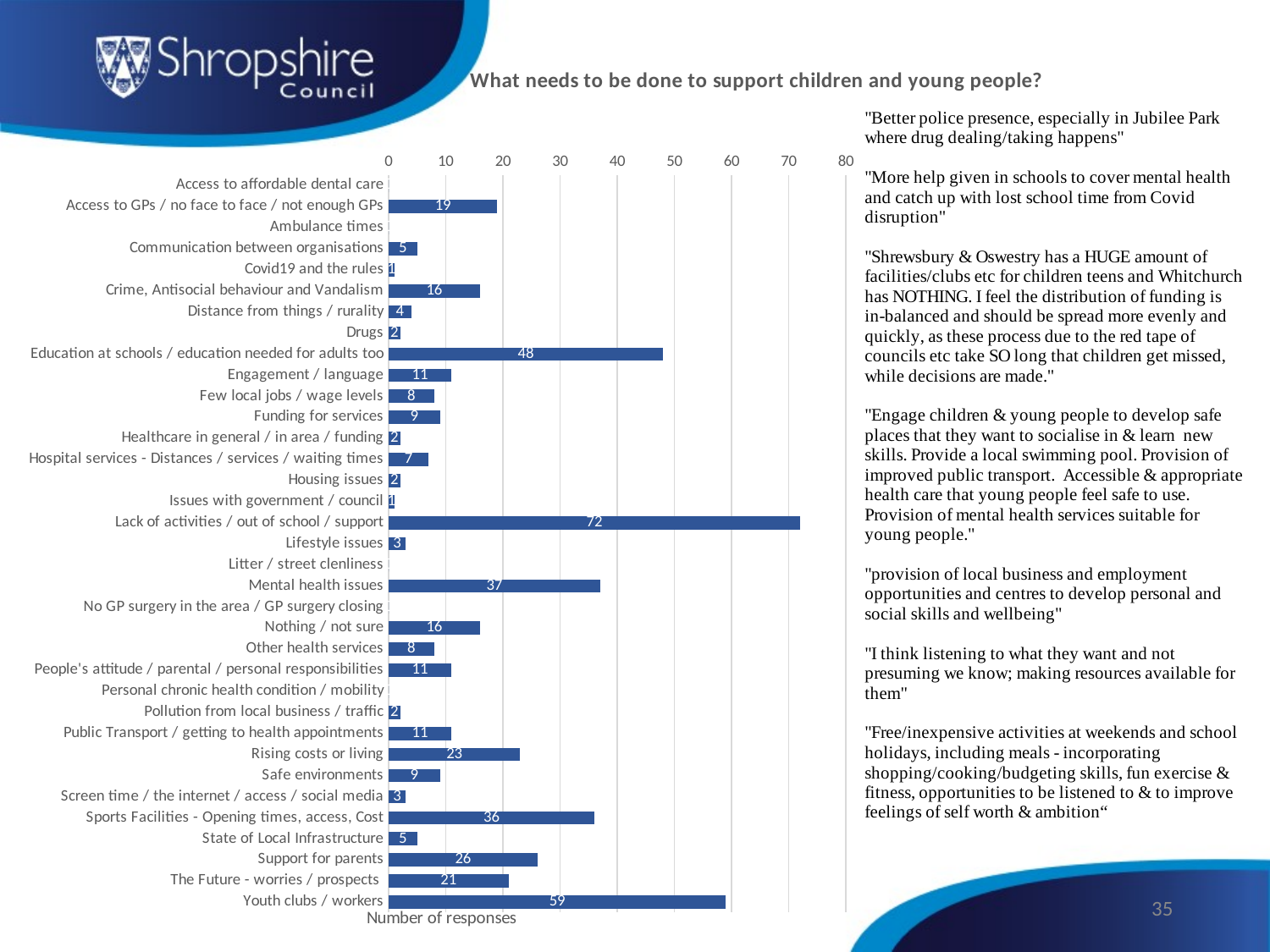
What is the number of responses for "Youth clubs / workers"? 59 Which has more responses: "Education at schools / education needed for adults too" or "Mental health issues"? Education at schools / education needed for adults too What is the number of responses for "Lack of activities / out of school / support"? 72 What is the number of responses for "Mental health issues"? 37 How many categories are listed on the chart's vertical axis? 35 What type of chart is shown on the slide? Bar chart What is the number of responses for "Support for parents"? 26 Is the value for "Sports Facilities - Opening times, access, Cost" greater or less than 30? greater What is the difference in responses between "Rising costs or living" and "The Future - worries / prospects"? 2 Which category has the highest number of responses? Lack of activities / out of school / support What is the label on the horizontal axis of the chart? Number of responses What is the difference in responses between "Lack of activities / out of school / support" and "Youth clubs / workers"? 13